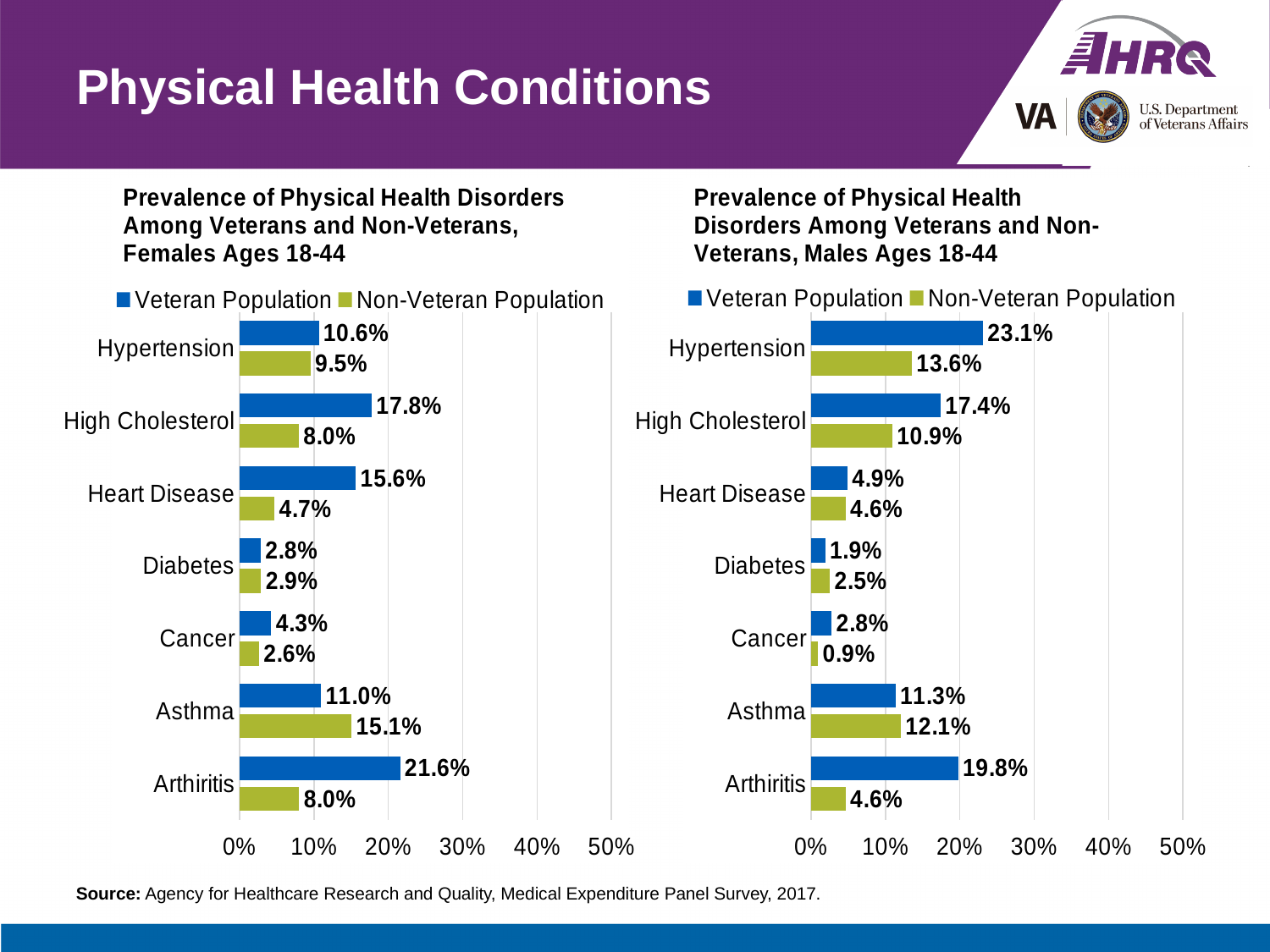
In the left chart (Females Ages 18-44), what is the Veteran Population value for Arthiritis? 21.6% In the right chart (Males Ages 18-44), is the Veteran Population value for Hypertension greater or less than 20%? greater How many health conditions are listed on the left chart (Females Ages 18-44)? 7 In the left chart (Females Ages 18-44), which is larger for Asthma: the Veteran Population value or the Non-Veteran Population value? Non-Veteran Population In the right chart (Males Ages 18-44), what is the difference between the Veteran and Non-Veteran Population values for Arthiritis? 15.2% What colour represents the Non-Veteran Population in both charts? Green In the right chart (Males Ages 18-44), which condition has the lowest Non-Veteran Population value? Cancer In the left chart (Females Ages 18-44), which condition has the highest Veteran Population value? Arthiritis What type of chart is the left chart (Females Ages 18-44)? Bar chart In the right chart (Males Ages 18-44), what is the Non-Veteran Population value for Hypertension? 13.6% How many series does the legend of the right chart (Males Ages 18-44) list? 2 In the left chart (Females Ages 18-44), what is the difference between the Veteran and Non-Veteran Population values for High Cholesterol? 9.8%